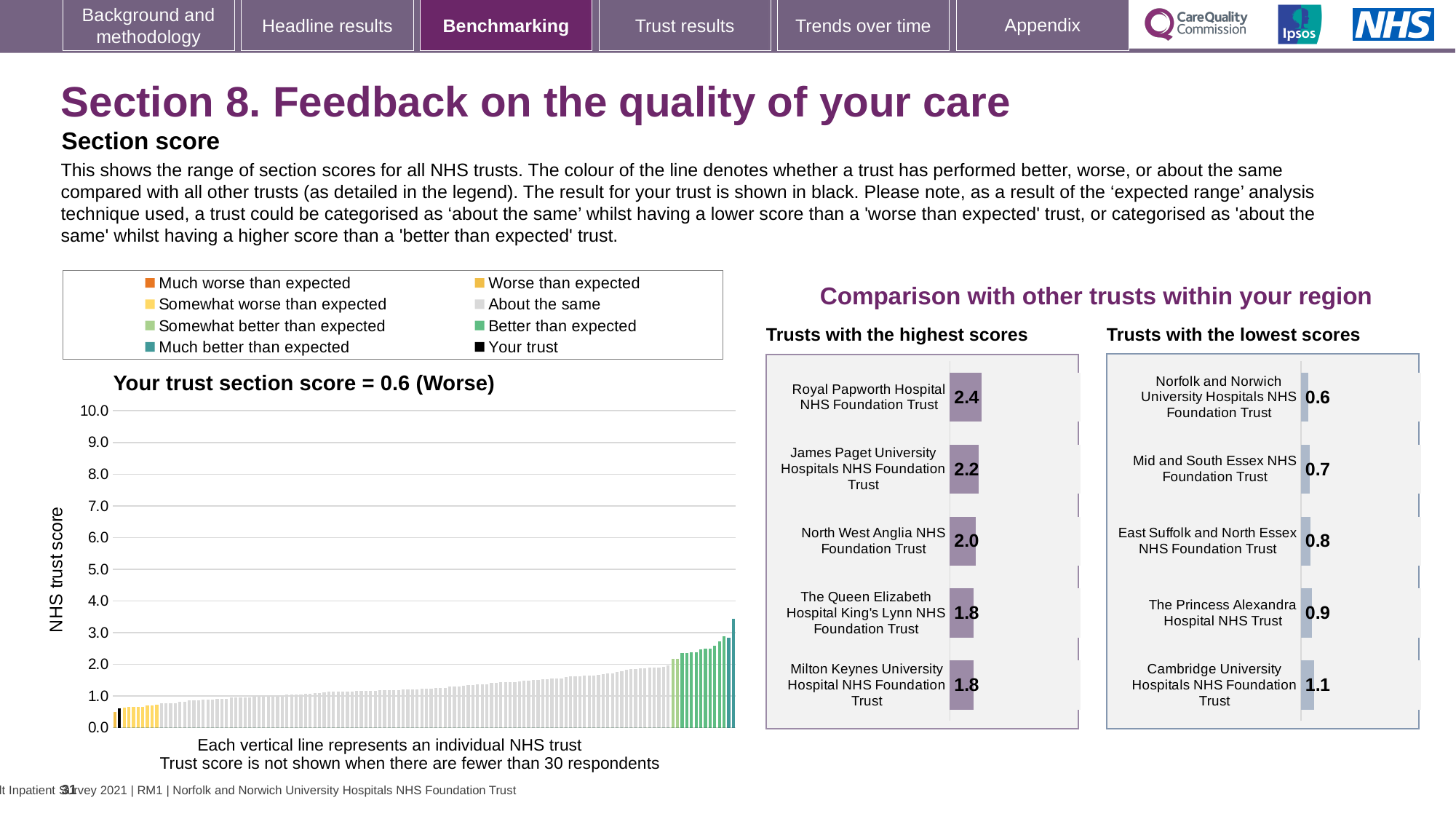
In the 'Your trust section score' chart, what is the section score for your trust? 0.6 In the 'Trusts with the lowest scores' chart, which has the larger score: Cambridge University Hospitals NHS Foundation Trust or East Suffolk and North Essex NHS Foundation Trust? Cambridge University Hospitals NHS Foundation Trust In the 'Trusts with the lowest scores' chart, what is the score for Mid and South Essex NHS Foundation Trust? 0.7 How many trusts are listed in the 'Trusts with the lowest scores' chart? 5 In the 'Your trust section score' chart, do the bars rise or fall from left to right? rise In the 'Trusts with the highest scores' chart, which trust has the highest score? Royal Papworth Hospital NHS Foundation Trust In the 'Your trust section score' chart, is the value of the tallest bar greater or less than 3.0? greater In the 'Trusts with the lowest scores' chart, which trust has the lowest score? Norfolk and Norwich University Hospitals NHS Foundation Trust In the 'Trusts with the highest scores' chart, what is the difference between the scores of Royal Papworth Hospital NHS Foundation Trust and James Paget University Hospitals NHS Foundation Trust? 0.2 How many entries does the legend above the 'Your trust section score' chart list? 8 In the 'Trusts with the highest scores' chart, what is the score for North West Anglia NHS Foundation Trust? 2.0 In the 'Trusts with the highest scores' chart, what is the score for Royal Papworth Hospital NHS Foundation Trust? 2.4